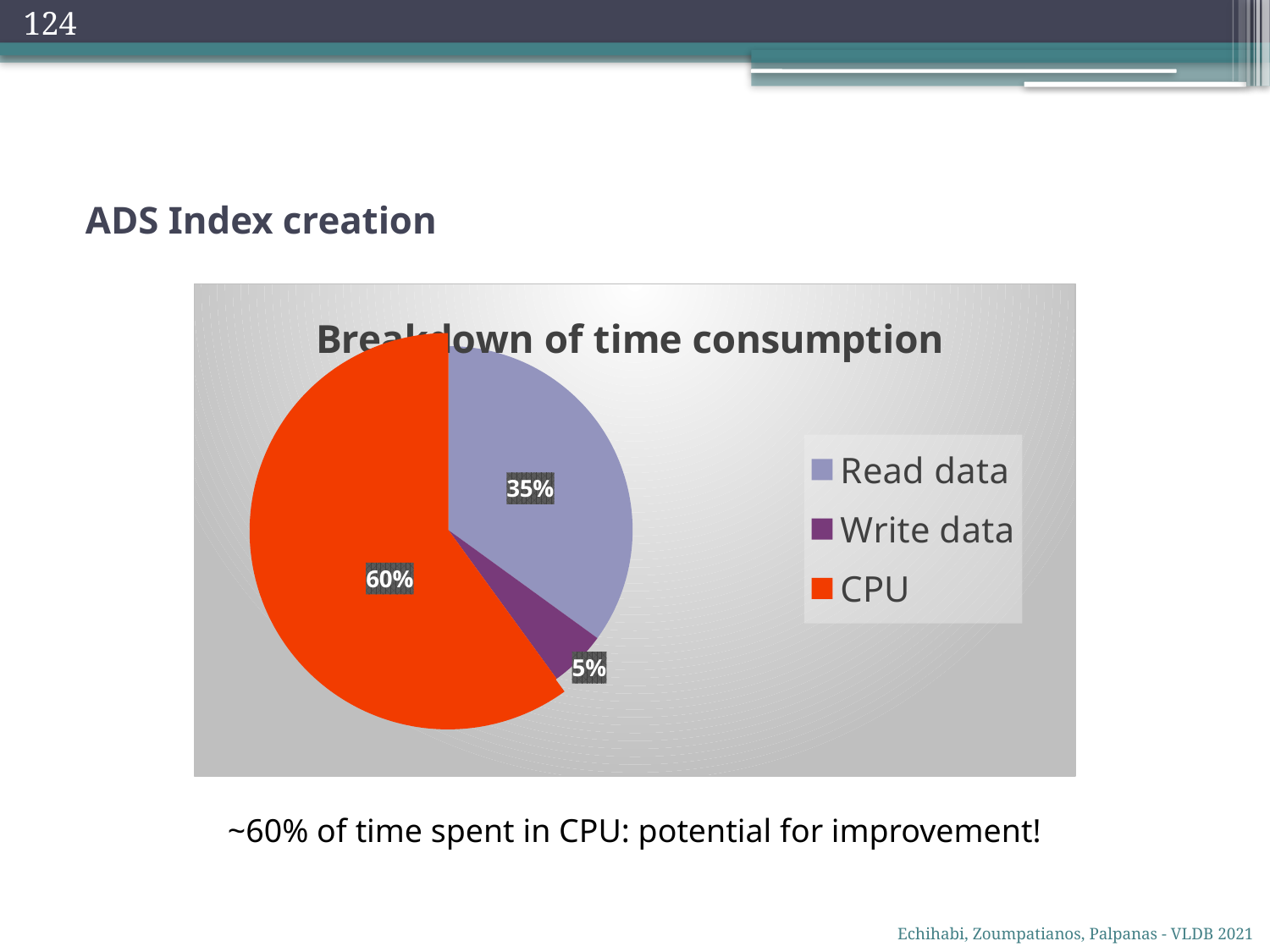
What share of time consumption is attributed to Write data? 5% Which category accounts for the largest share of time consumption? CPU What is the difference in percentage points between the CPU share and the Read data share? 25% What share of time consumption is attributed to CPU? 60% Which is larger, the share for Read data or the share for Write data? Read data What kind of chart is shown on the slide? pie chart How many slices does the pie chart have? 3 Which colour represents CPU in the pie chart? orange-red Which category accounts for the smallest share of time consumption? Write data What share of time consumption is attributed to Read data? 35% What is the title of the chart? Breakdown of time consumption How many categories does the legend list? 3